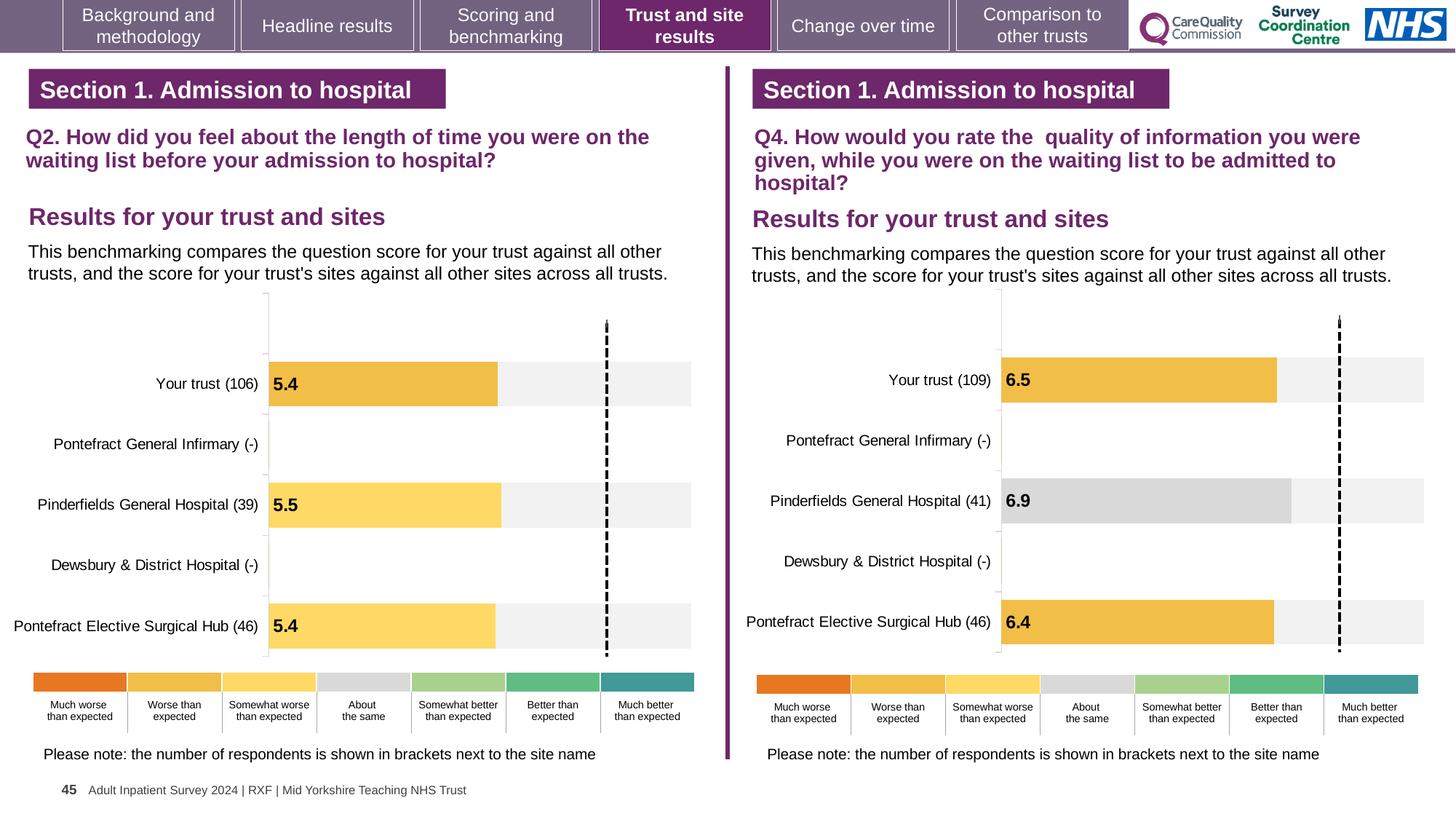
In the Q4 chart on the right, what is the score for Pontefract Elective Surgical Hub? 6.4 In the Q4 chart on the right, what is the difference between the scores for Pinderfields General Hospital and Your trust? 0.4 In the Q4 chart on the right, which is larger: the score for Your trust or the score for Pontefract Elective Surgical Hub? Your trust In the Q2 chart on the left, what is the score for Pinderfields General Hospital? 5.5 How many site or trust rows are listed in the Q2 chart on the left? 5 What kind of chart is used in the Q2 chart on the left? Bar chart In the Q2 chart on the left, how many respondents are shown in brackets for Pontefract Elective Surgical Hub? 46 In the Q4 chart on the right, which site or trust row has the highest score? Pinderfields General Hospital In the Q4 chart on the right, which site or trust row has the lowest score? Pontefract Elective Surgical Hub In the Q2 chart on the left, what is the score for Your trust? 5.4 In the Q2 chart on the left, what is the difference between the scores for Pinderfields General Hospital and Pontefract Elective Surgical Hub? 0.1 In the Q4 chart on the right, what is the score for Pinderfields General Hospital? 6.9